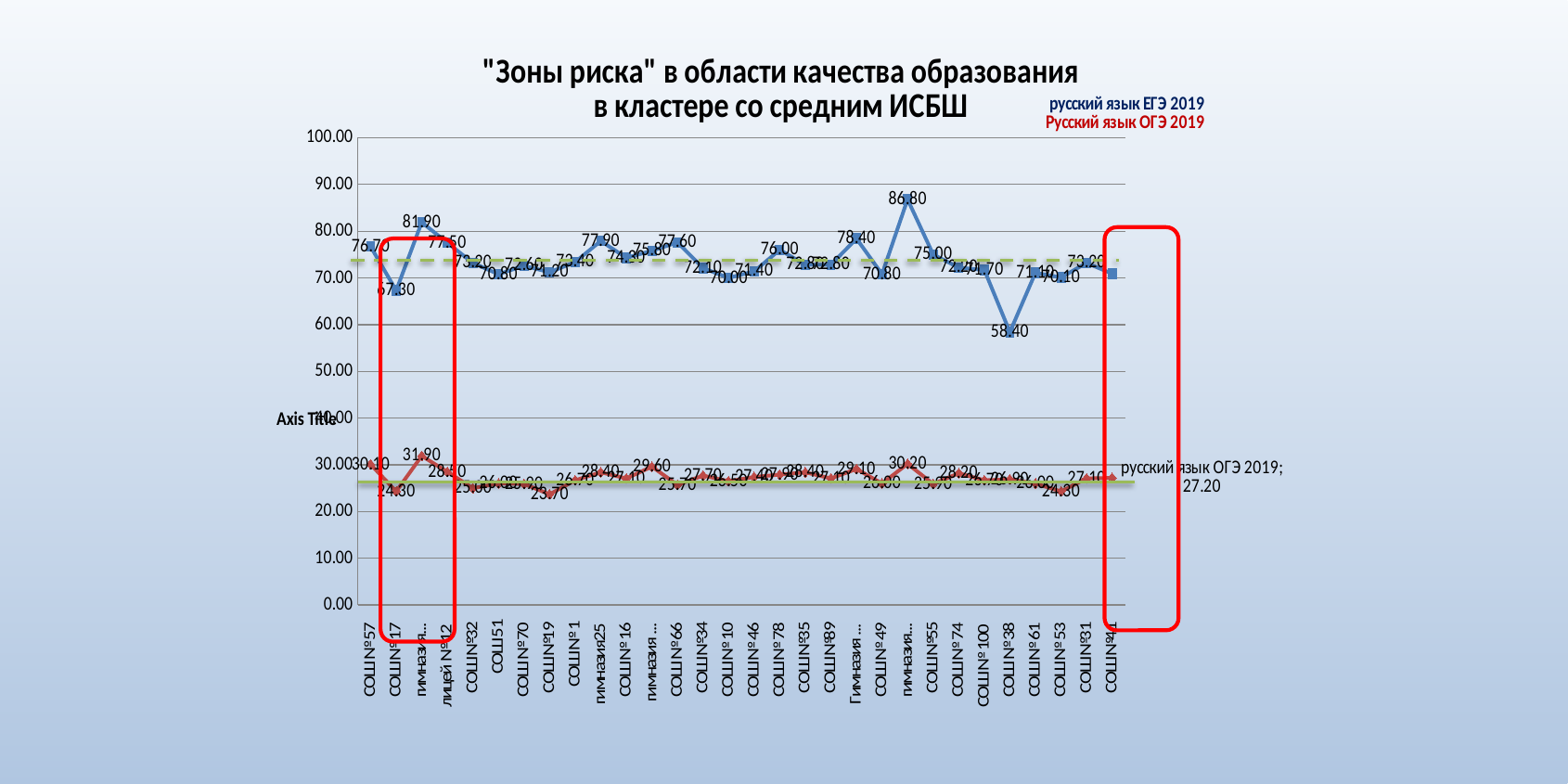
How many series does the legend list? 2 What is the difference between the русский язык ЕГЭ 2019 values for СОШ№57 and СОШ№17? 9.40 What is the value of the русский язык ЕГЭ 2019 series for СОШ№38? 58.40 What kind of chart is shown on the slide? line chart What is the value of the Русский язык ОГЭ 2019 series for СОШ№17? 24.30 Which school has the lowest value in the русский язык ЕГЭ 2019 series? СОШ№38 Is the русский язык ЕГЭ 2019 value for СОШ№38 greater or less than 60.00? less What is the value of the русский язык ЕГЭ 2019 series for СОШ№17? 67.30 Which has the larger русский язык ЕГЭ 2019 value, СОШ№17 or СОШ№38? СОШ№17 Is the Русский язык ОГЭ 2019 value for СОШ№57 greater or less than 40.00? less What is the value of the русский язык ЕГЭ 2019 series for СОШ№57? 76.70 What is the value of the Русский язык ОГЭ 2019 series for СОШ№4? 27.20